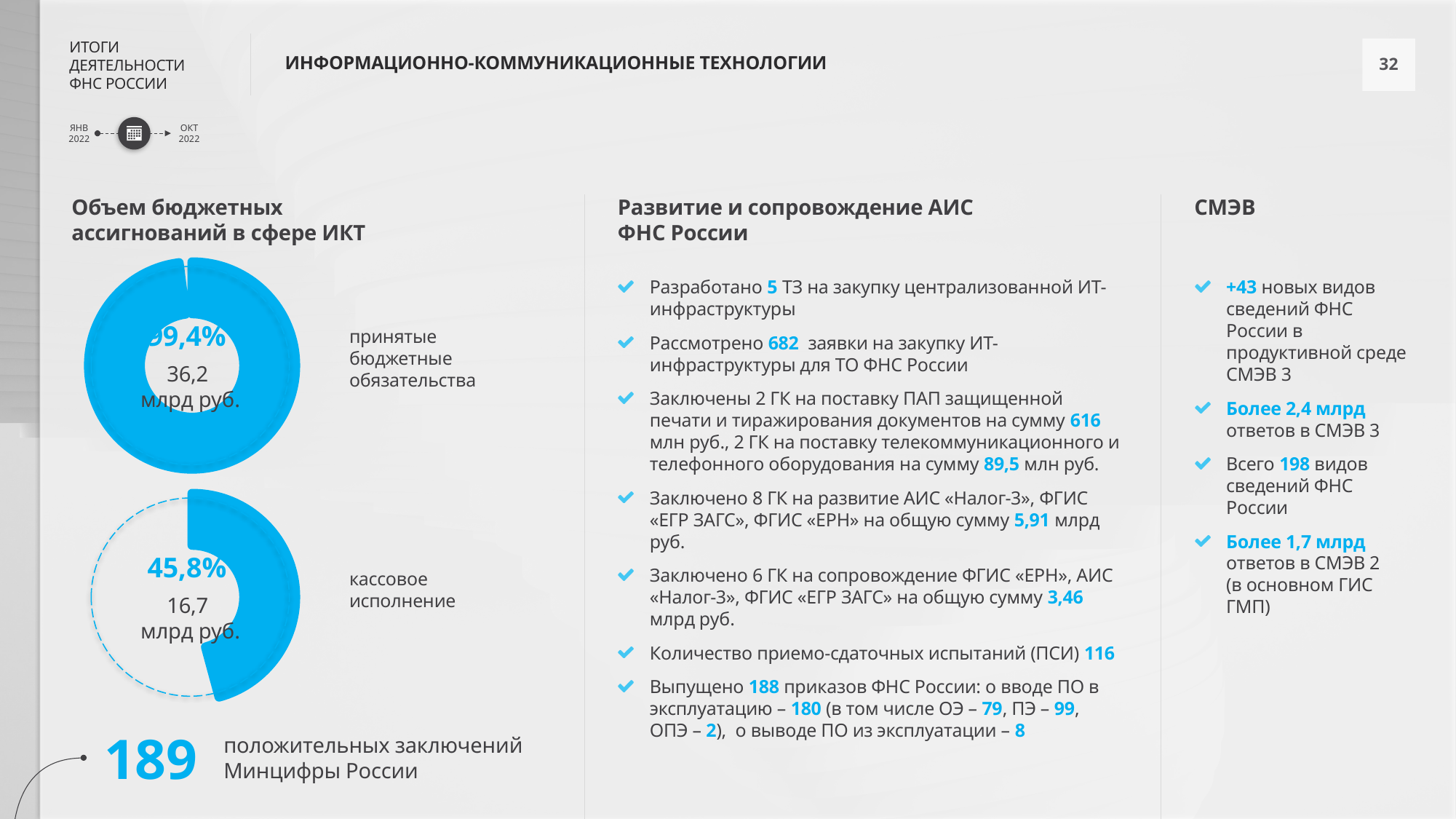
In the lower donut chart on the left, is the filled share for 'кассовое исполнение' greater or less than 50%? less What is the difference between the amounts shown in the two donut charts on the left, 36,2 млрд руб. and 16,7 млрд руб.? 19,5 млрд руб. What colour is the filled portion of the donut charts on the left of the slide? Blue In the lower donut chart on the left, what percentage is shown for 'кассовое исполнение'? 45,8% What is the heading above the two donut charts on the left of the slide? Объем бюджетных ассигнований в сфере ИКТ In the lower donut chart on the left, what amount in rubles is shown for 'кассовое исполнение'? 16,7 млрд руб. Which of the two donut charts on the left shows the larger percentage: 'принятые бюджетные обязательства' or 'кассовое исполнение'? принятые бюджетные обязательства In the upper donut chart on the left, what percentage is shown for 'принятые бюджетные обязательства'? 99,4% What is the difference in percentage points between the 'принятые бюджетные обязательства' donut (99,4%) and the 'кассовое исполнение' donut (45,8%)? 53,6 percentage points What kind of chart is used to show the 'принятые бюджетные обязательства' value on the left of the slide? Donut (pie) chart In the upper donut chart on the left, what amount in rubles is shown for 'принятые бюджетные обязательства'? 36,2 млрд руб. How many donut charts are shown on the slide? 2